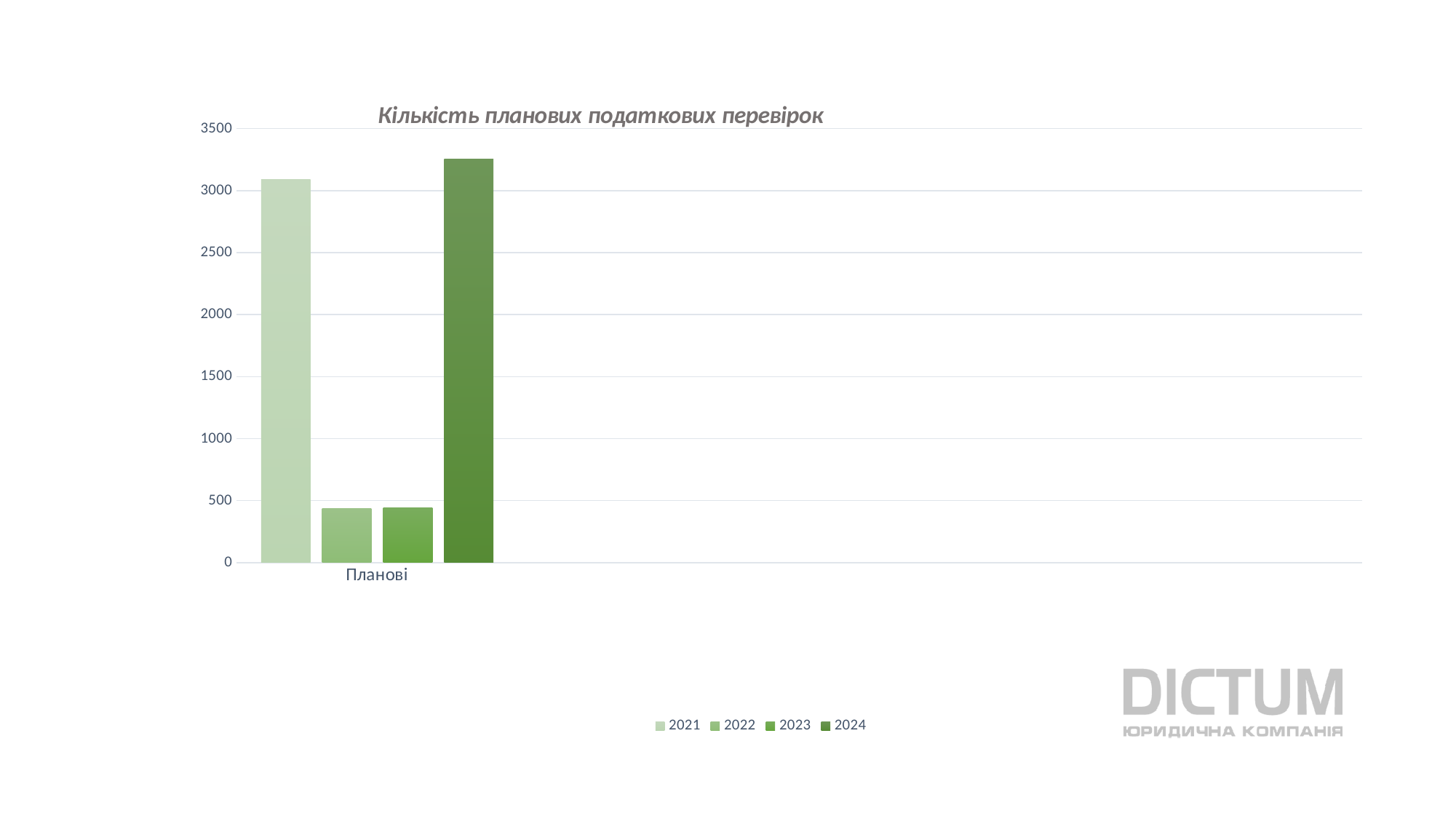
Is the value for 2023 greater or less than 1000? less What kind of chart is shown on the slide? bar chart Is the value for 2022 greater or less than 500? less How many categories are shown on the x axis? 1 Which series has the highest bar for Планові? 2024 How many series does the legend list? 4 What is the title of the chart? Кількість планових податкових перевірок Is the value for 2024 greater or less than 3000? greater Which is larger, the value for 2021 or the value for 2022? 2021 Which is larger, the value for 2023 or the value for 2024? 2024 Which years are listed in the legend? 2021, 2022, 2023, 2024